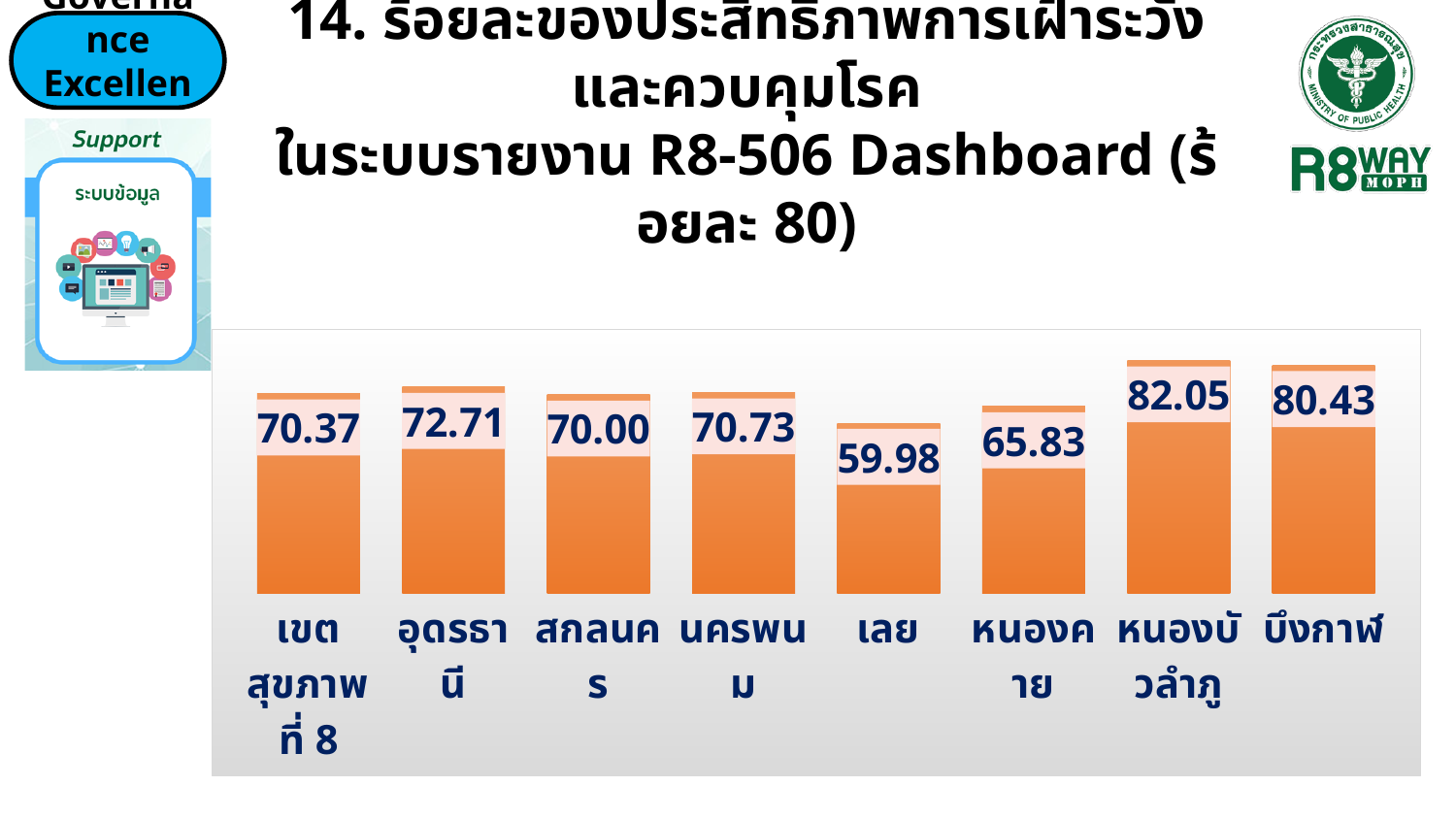
What is the difference between the values for บึงกาฬ and หนองคาย? 14.60 What kind of chart is shown on the slide? bar chart What is the value for อุดรธานี? 72.71 What colour are the bars in the chart? orange What is the value for เลย? 59.98 Which category has the lowest value? เลย Which is larger, the value for อุดรธานี or the value for นครพนม? อุดรธานี What is the value for เขตสุขภาพที่ 8? 70.37 What is the value for หนองบัวลำภู? 82.05 Which category has the highest value? หนองบัวลำภู How many categories are shown in the chart? 8 What is the difference between the values for หนองบัวลำภู and เลย? 22.07